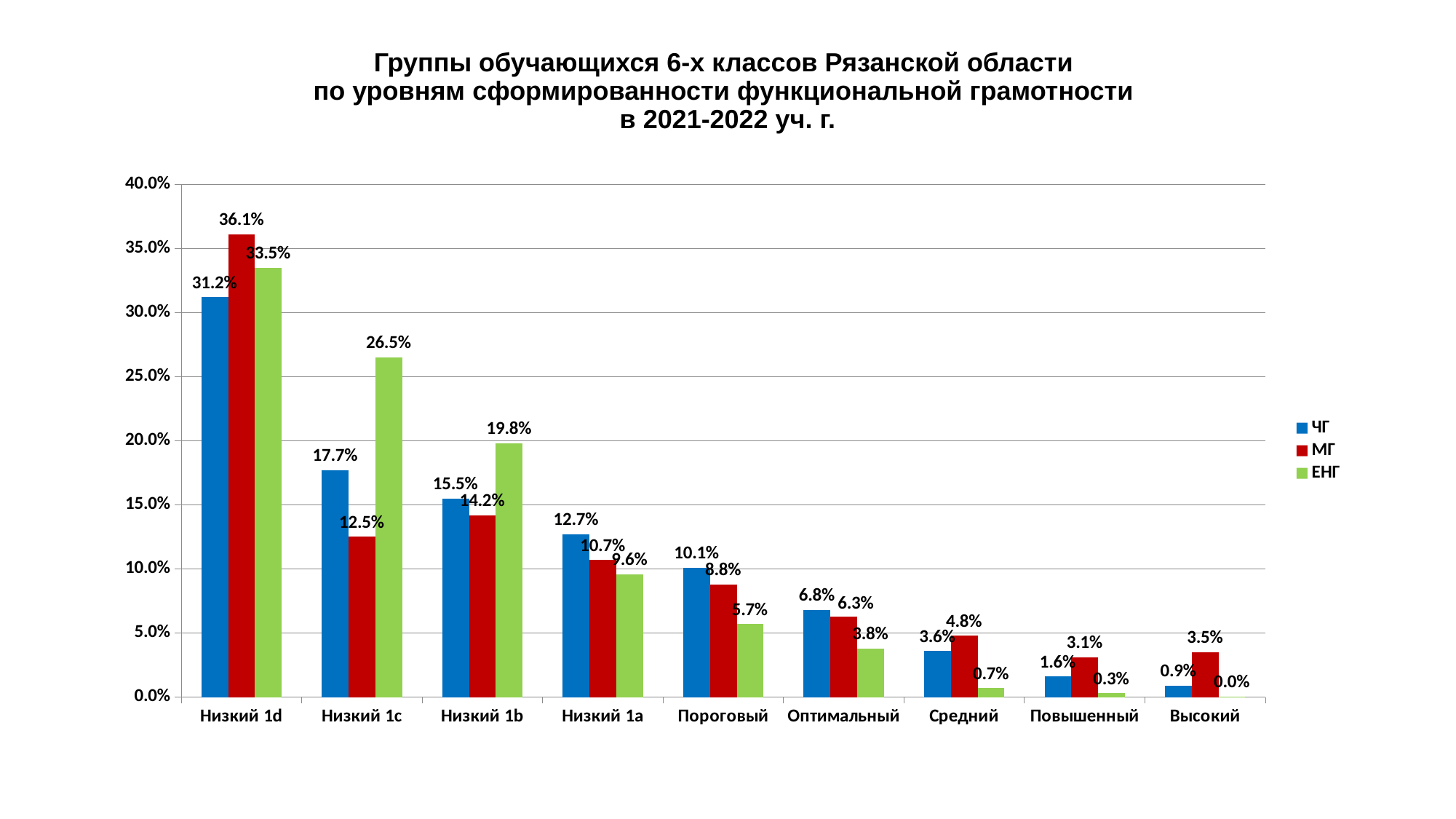
What is the value for МГ in the Повышенный category? 3.1% Which category has the highest value for the МГ series? Низкий 1d What kind of chart is shown on the slide? Bar chart What is the value for ЧГ in the Низкий 1d category? 31.2% How many categories are shown on the x axis? 9 In the Высокий category, which series has the larger value, ЧГ or МГ? МГ What is the value for ЕНГ in the Низкий 1c category? 26.5% Which colour represents the ЕНГ series in the legend? Green Is the value for ЕНГ in the Низкий 1b category greater or less than 15.0%? greater What is the difference between the ЕНГ and МГ values in the Низкий 1c category? 14.0% Which category has the lowest value for the ЕНГ series? Высокий How many series does the legend list? 3